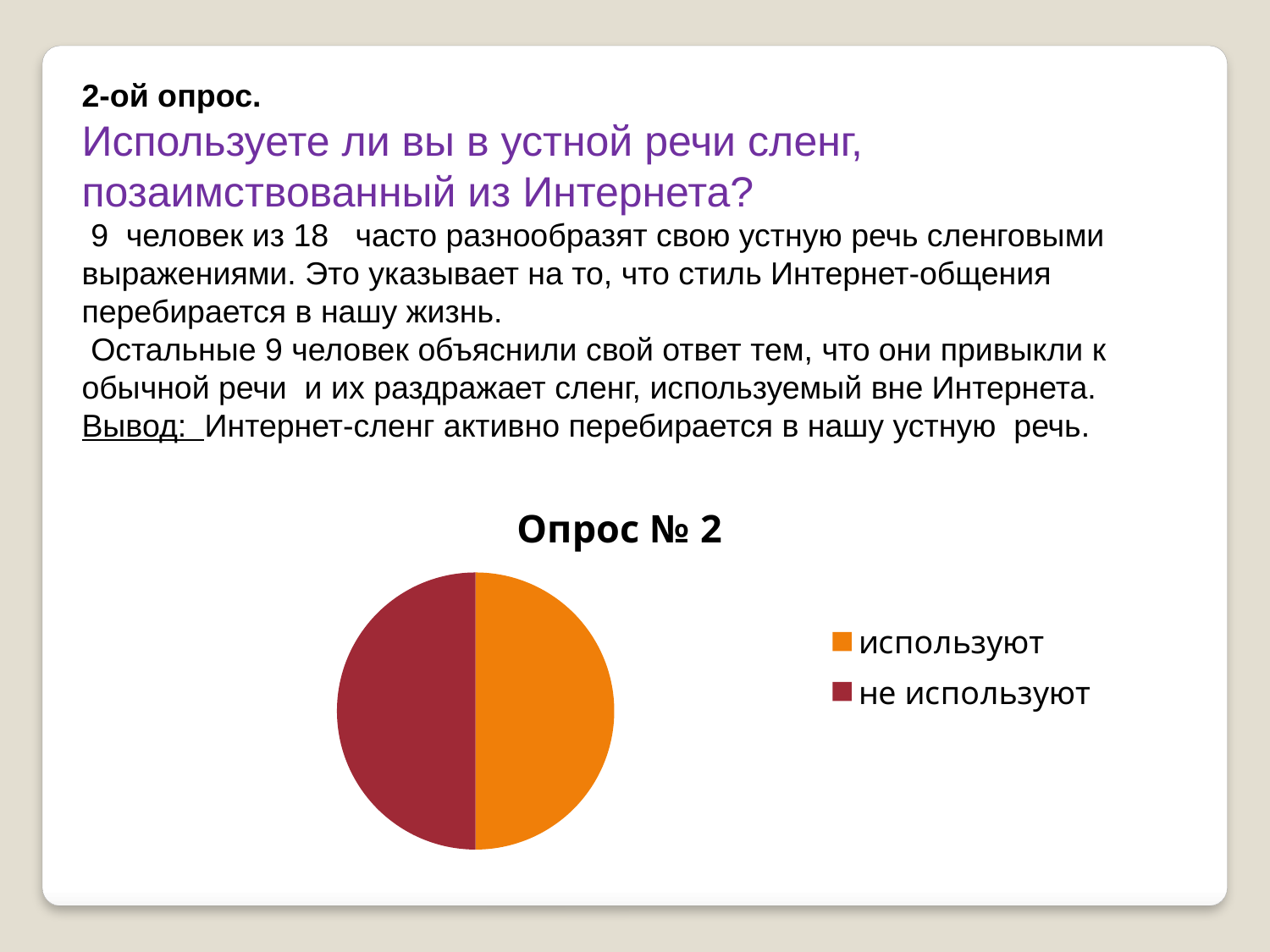
How many entries does the chart legend list? 2 What kind of chart is shown on the slide? pie chart What share of the pie does the 'не используют' slice take? half Which legend entry is shown in orange? используют What share of the pie does the 'используют' slice take? half How many slices does the pie chart have? 2 What is the title of the chart? Опрос № 2 Are the two slices of the pie chart roughly equal in size? yes